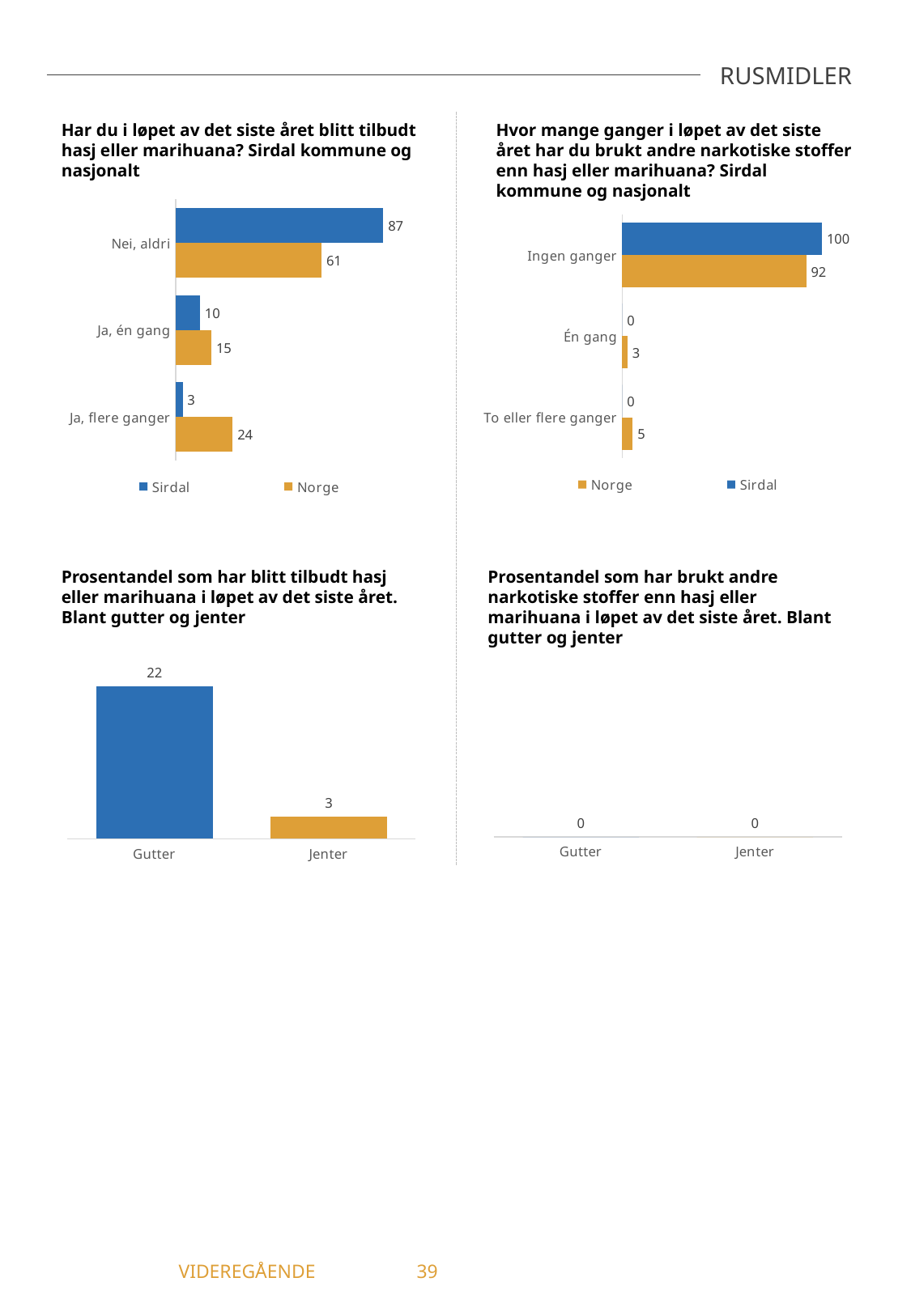
In the top-right chart, what is the value for Norge for 'To eller flere ganger'? 5 In the top-right chart, how many categories are shown? 3 In the bottom-left chart, what is the value for Gutter? 22 In the top-left chart, what is the value for Norge for 'Ja, flere ganger'? 24 In the top-left chart, which is larger for 'Ja, én gang': Sirdal or Norge? Norge In the top-left chart, what is the difference between the Norge and Sirdal values for 'Ja, flere ganger'? 21 In the top-left chart, how many series does the legend list? 2 In the bottom-right chart, what is the value for Jenter? 0 In the top-left chart, what is the value for Sirdal for 'Nei, aldri'? 87 In the top-right chart, what is the value for Sirdal for 'Ingen ganger'? 100 In the bottom-left chart, which category has the lowest value? Jenter What kind of chart is the bottom-left chart? Bar chart